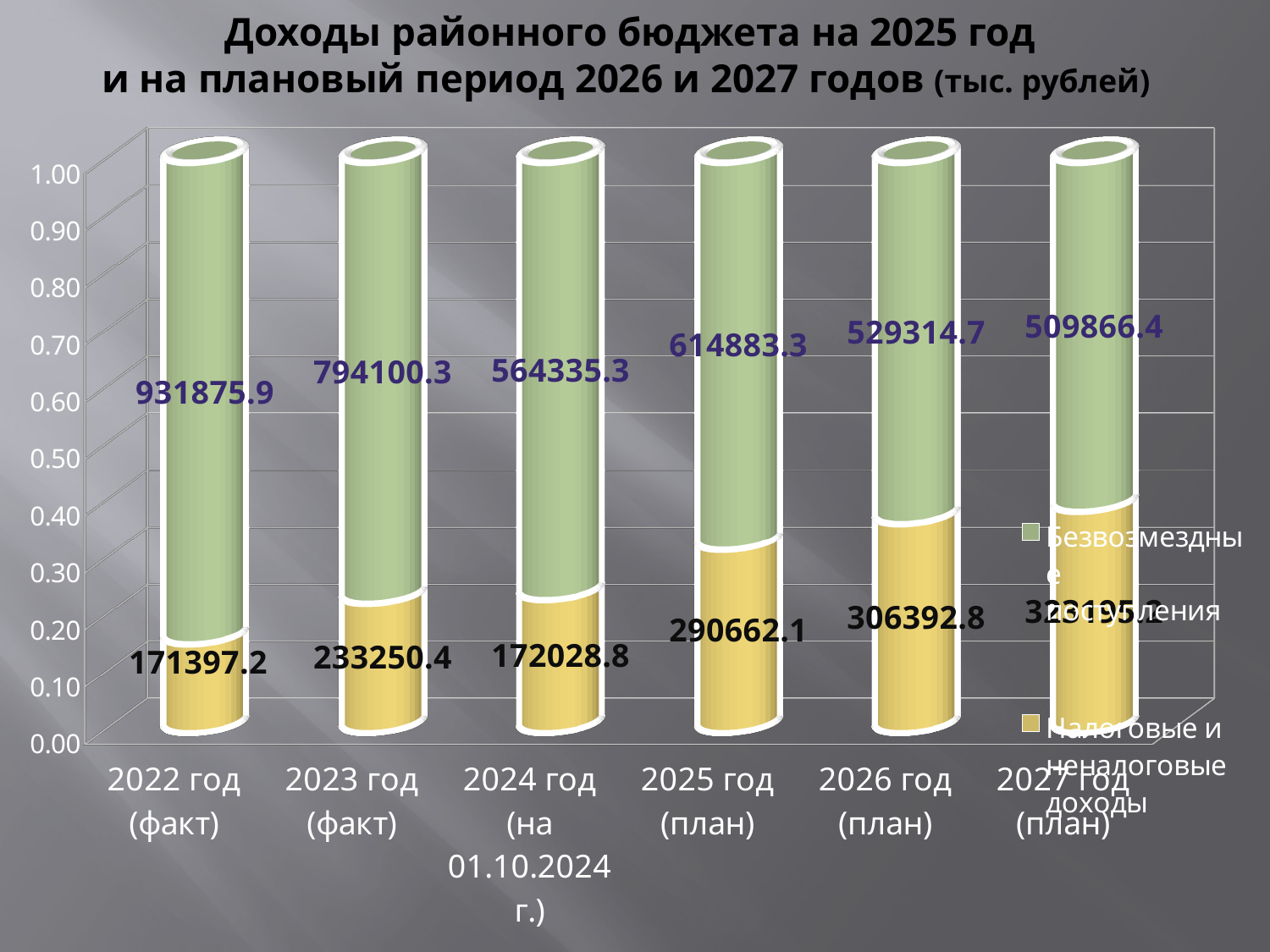
How many series does the legend list? 2 What is the value of Безвозмездные поступления for 2022 год (факт)? 931875.9 What is the total of the two series for 2022 год (факт)? 1103273.1 What is the value of Налоговые и неналоговые доходы for 2025 год (план)? 290662.1 Which year has the highest value of Безвозмездные поступления? 2022 год (факт) Which year has the lowest value of Безвозмездные поступления? 2027 год (план) What is the difference between Безвозмездные поступления in 2022 год (факт) and 2023 год (факт)? 137775.6 How many year categories are shown on the x axis? 6 What is the value of Налоговые и неналоговые доходы for 2023 год (факт)? 233250.4 Which is larger: Налоговые и неналоговые доходы for 2025 год (план) or for 2026 год (план)? 2026 год (план) What kind of chart is shown on the slide? Stacked bar chart What is the value of Безвозмездные поступления for 2027 год (план)? 509866.4